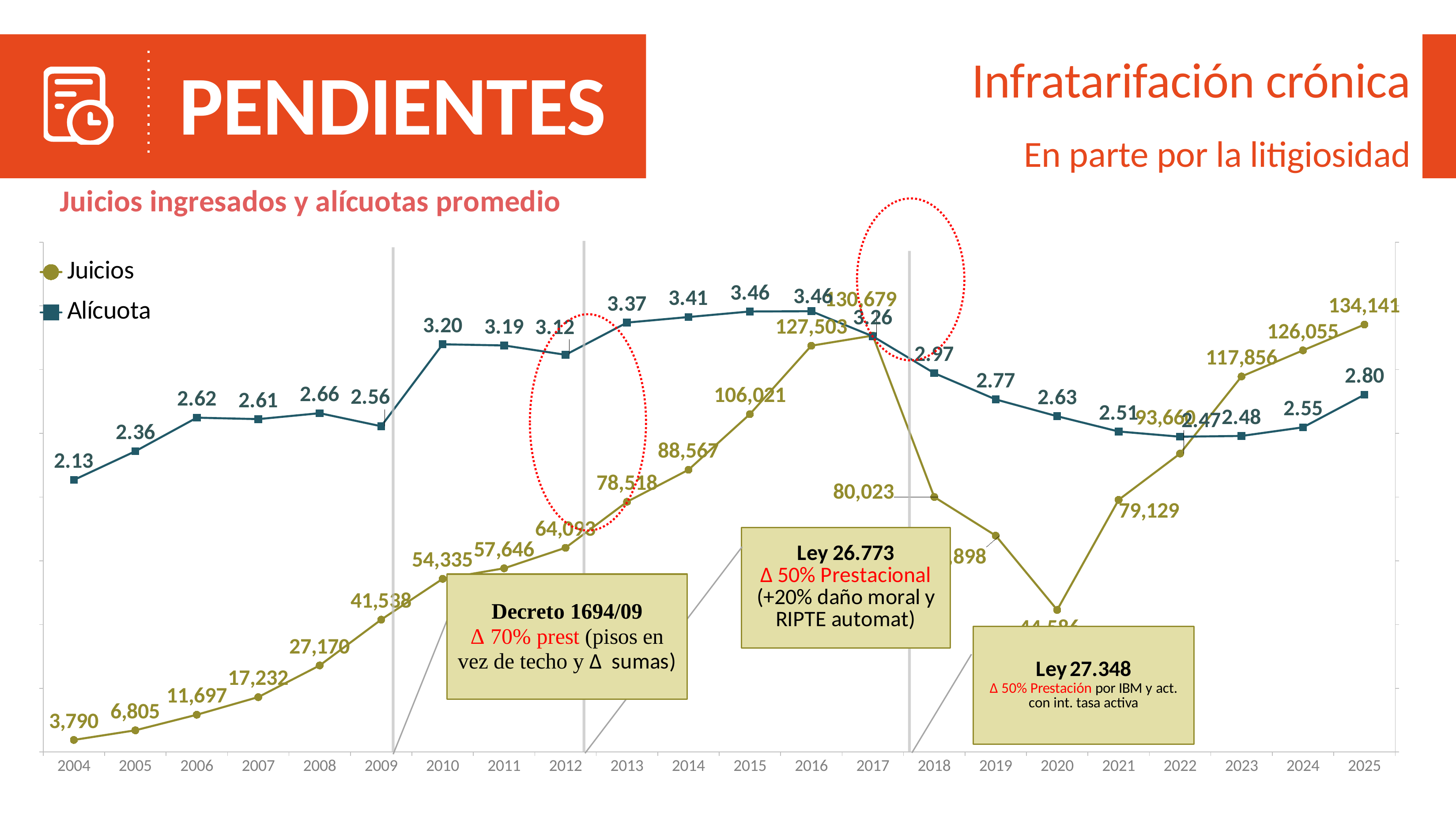
How many years are shown on the x axis? 22 What is the value of Juicios for 2017? 130,679 Which year has the larger Juicios value, 2016 or 2018? 2016 What is the difference between the Juicios values for 2025 and 2024? 8,086 What is the title of the chart? Juicios ingresados y alícuotas promedio What is the Alícuota value for 2025? 2.80 What is the Alícuota value for 2010? 3.20 In which year is the Juicios value highest? 2025 How many series does the legend list? 2 In which year is the Alícuota value lowest? 2004 What kind of chart is shown on the slide? Line chart Do the Juicios values rise or fall from 2004 to 2017? Rise